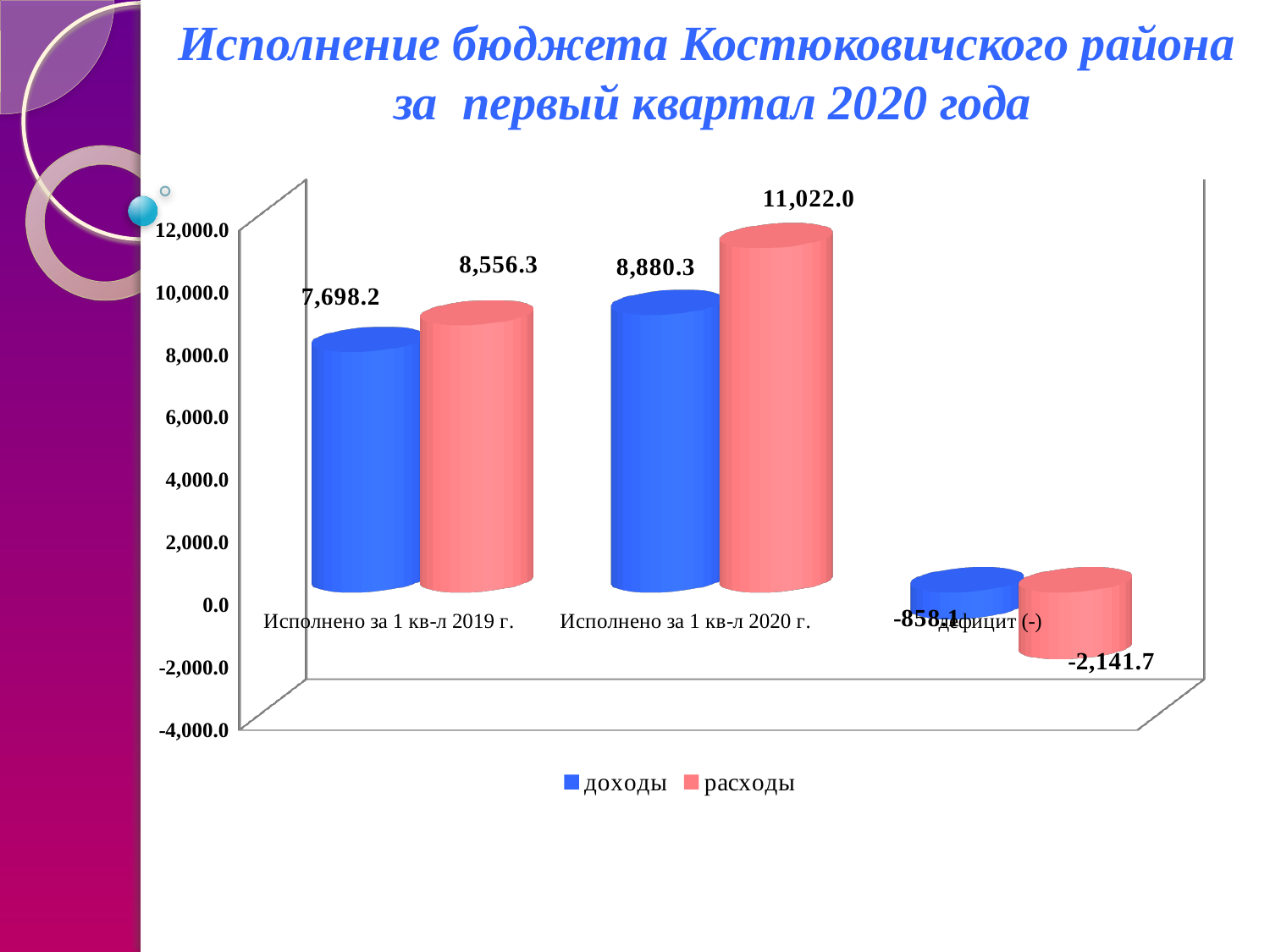
How many series does the legend list? 2 Which category has the lowest доходы value? дефицит (-) Which category has the highest расходы value? Исполнено за 1 кв-л 2020 г. What is the value of доходы for Исполнено за 1 кв-л 2020 г.? 8,880.3 What kind of chart is shown on the slide? bar chart What is the value of расходы for Исполнено за 1 кв-л 2019 г.? 8,556.3 What is the value of доходы for Исполнено за 1 кв-л 2019 г.? 7,698.2 How many categories are shown on the x axis? 3 What is the difference between расходы and доходы for Исполнено за 1 кв-л 2020 г.? 2,141.7 Which is larger for Исполнено за 1 кв-л 2019 г.: доходы or расходы? расходы What is the value of расходы for дефицит (-)? -2,141.7 What is the value of расходы for Исполнено за 1 кв-л 2020 г.? 11,022.0